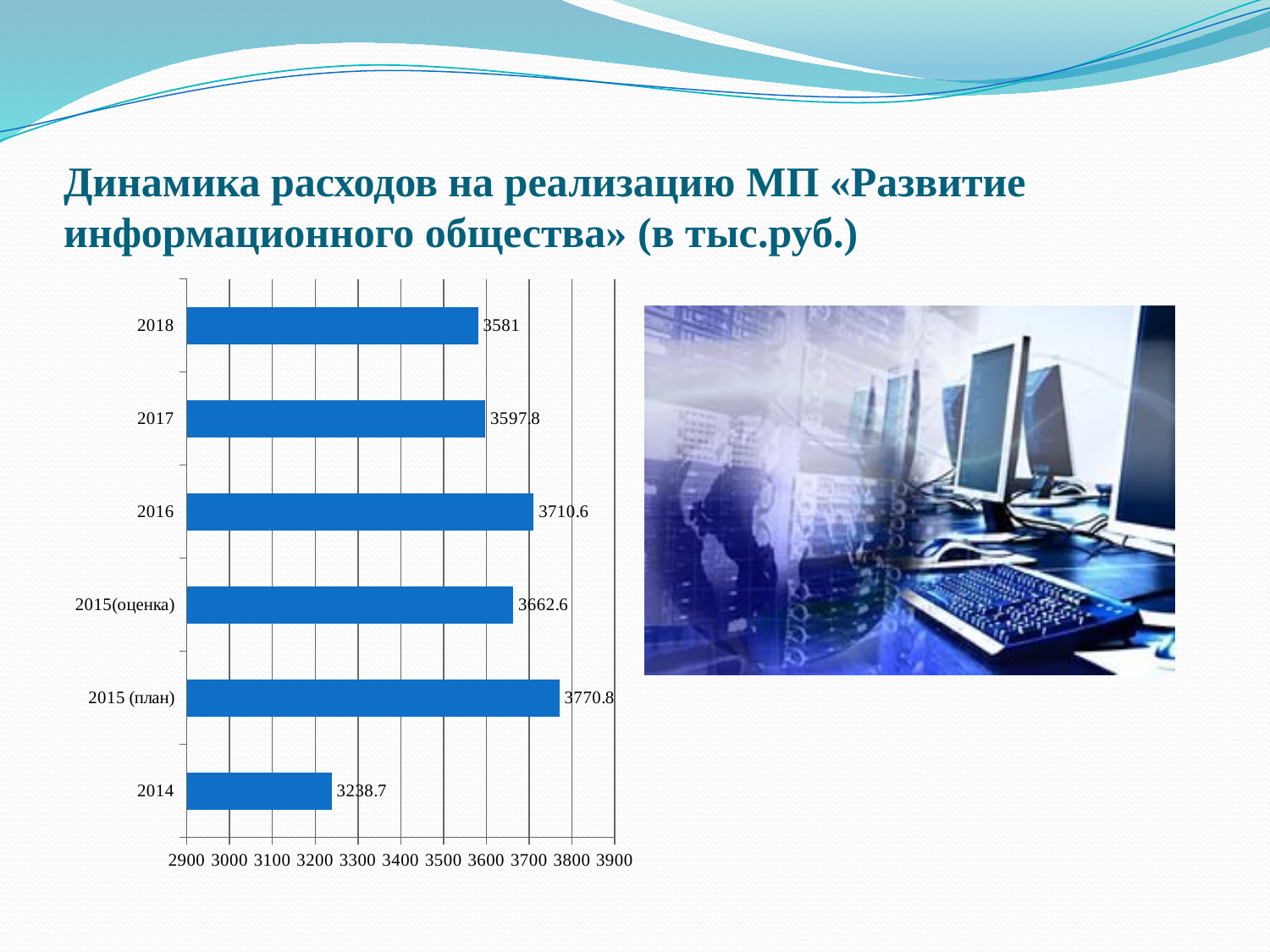
What is the value for 2016? 3710.6 How many categories are shown in the chart? 6 Which category has the highest value? 2015 (план) What is the difference between the values for 2015 (план) and 2015(оценка)? 108.2 What is the value for 2014? 3238.7 Is the value for 2014 greater or less than 3300? less What is the value for 2015 (план)? 3770.8 What is the difference between the values for 2017 and 2018? 16.8 Which is larger, the value for 2017 or the value for 2016? 2016 What is the value for 2018? 3581 What kind of chart is shown on the slide? bar chart Which category has the lowest value? 2014